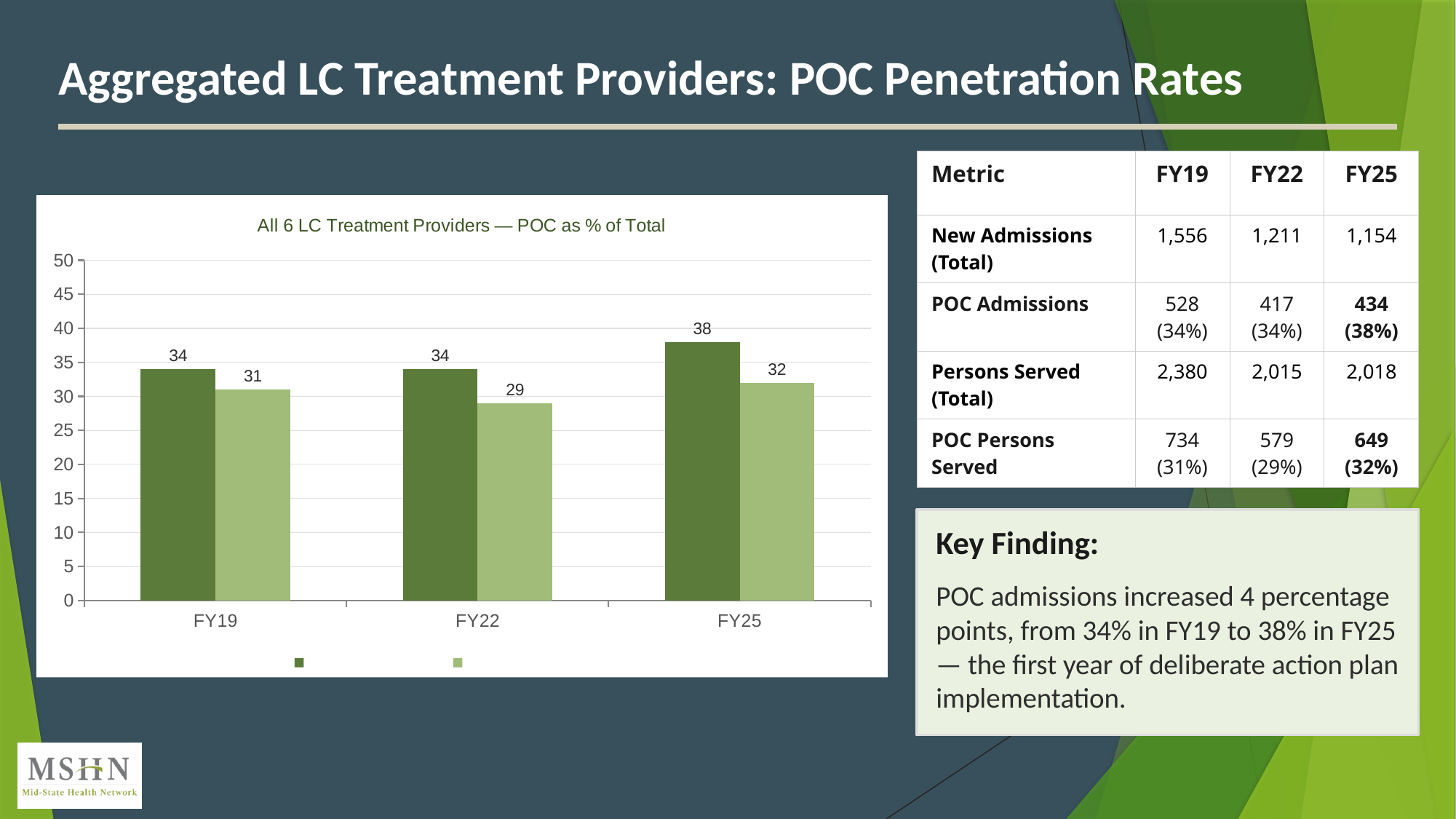
What is the value of the light green bar for FY22? 29 What is the value of the dark green bar for FY25? 38 What type of chart is shown on the slide? bar chart Is the value of the dark green bar for FY25 greater or less than 35? greater In which fiscal year is the light green bar lowest? FY22 By how much does the dark green bar increase from FY19 to FY25? 4 How many fiscal years are shown on the x axis? 3 What is the difference between the dark green and light green bars for FY25? 6 In which fiscal year is the dark green bar highest? FY25 For FY19, which bar is larger, the dark green or the light green? dark green How many series does the legend show? 2 What is the title of the chart? All 6 LC Treatment Providers — POC as % of Total